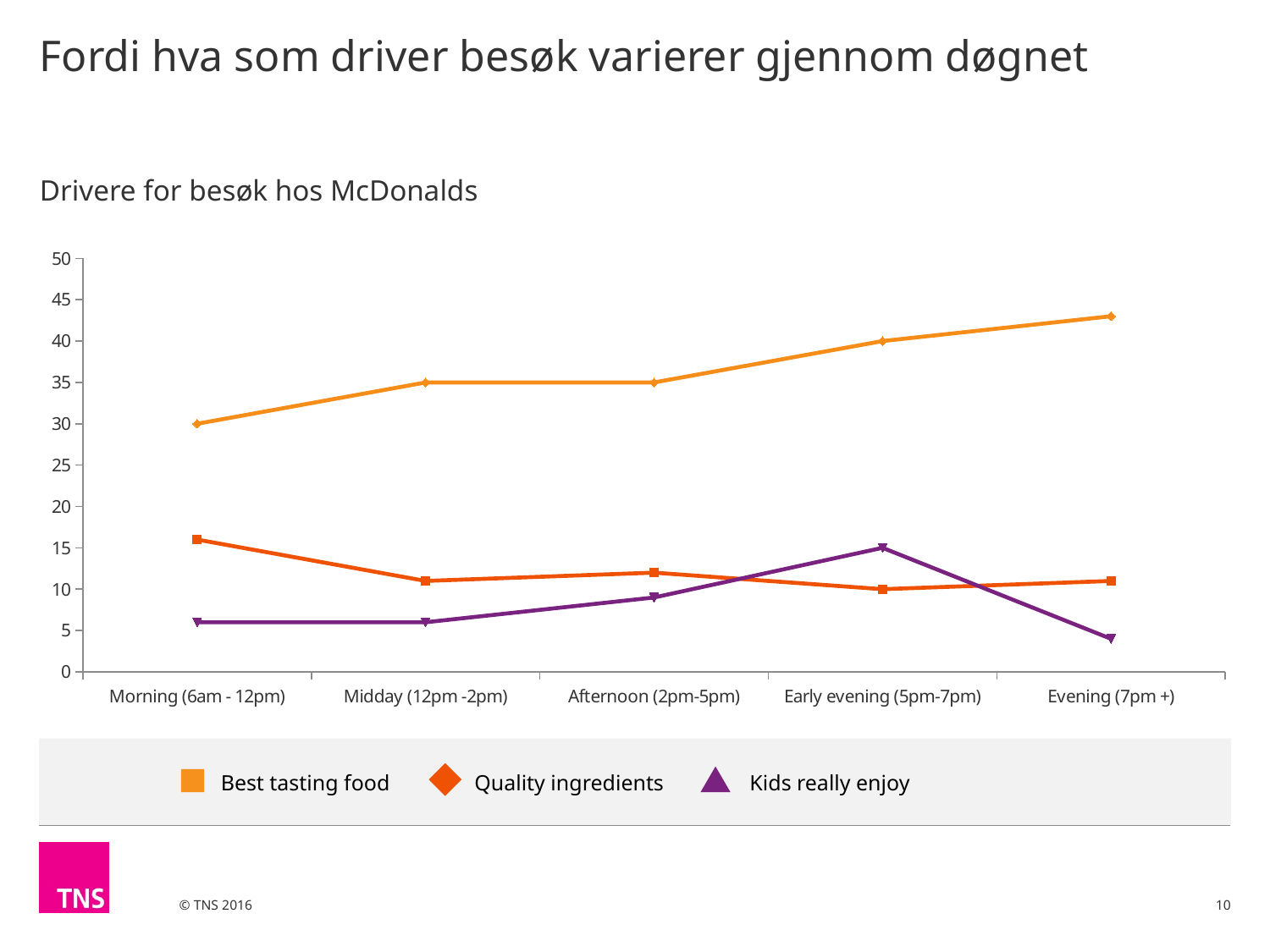
What kind of chart is shown on the slide? line chart How many time periods are shown on the x axis? 5 In which time period is the value for Kids really enjoy lowest? Evening (7pm +) What is the value for Best tasting food at Morning (6am - 12pm)? 30 At Early evening (5pm-7pm), which is larger: Kids really enjoy or Quality ingredients? Kids really enjoy In which time period is the value for Kids really enjoy highest? Early evening (5pm-7pm) Does the value for Best tasting food rise or fall from Morning (6am - 12pm) to Evening (7pm +)? rise Is the value for Kids really enjoy at Morning (6am - 12pm) greater or less than 10? less In which time period is the value for Best tasting food highest? Evening (7pm +) Is the value for Best tasting food at Evening (7pm +) greater or less than 40? greater How many series does the legend list? 3 What is the title of the chart? Drivere for besøk hos McDonalds